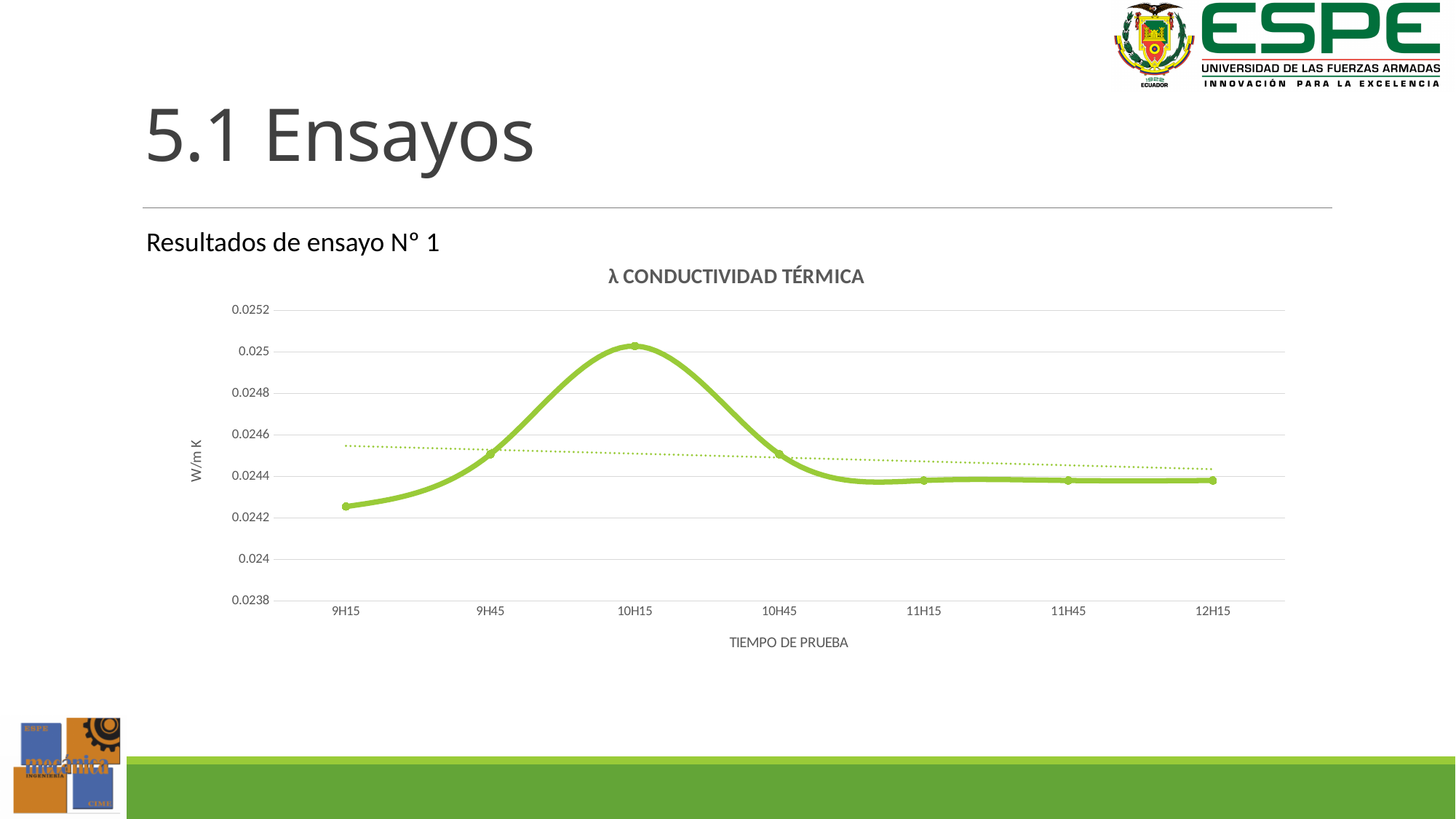
What kind of chart is shown on the slide? line chart Does the dotted trend line rise or fall from left to right? fall Which is larger, the value at 10H15 or the value at 12H15? 10H15 How many time points are plotted along the x axis? 7 At which time is the thermal conductivity lowest? 9H15 Is the value at 9H45 greater or less than 0.0244? greater Is the value at 9H15 greater or less than 0.0244? less What is the title of the chart? λ CONDUCTIVIDAD TÉRMICA At which time is the thermal conductivity highest? 10H15 What is the label of the x axis? TIEMPO DE PRUEBA